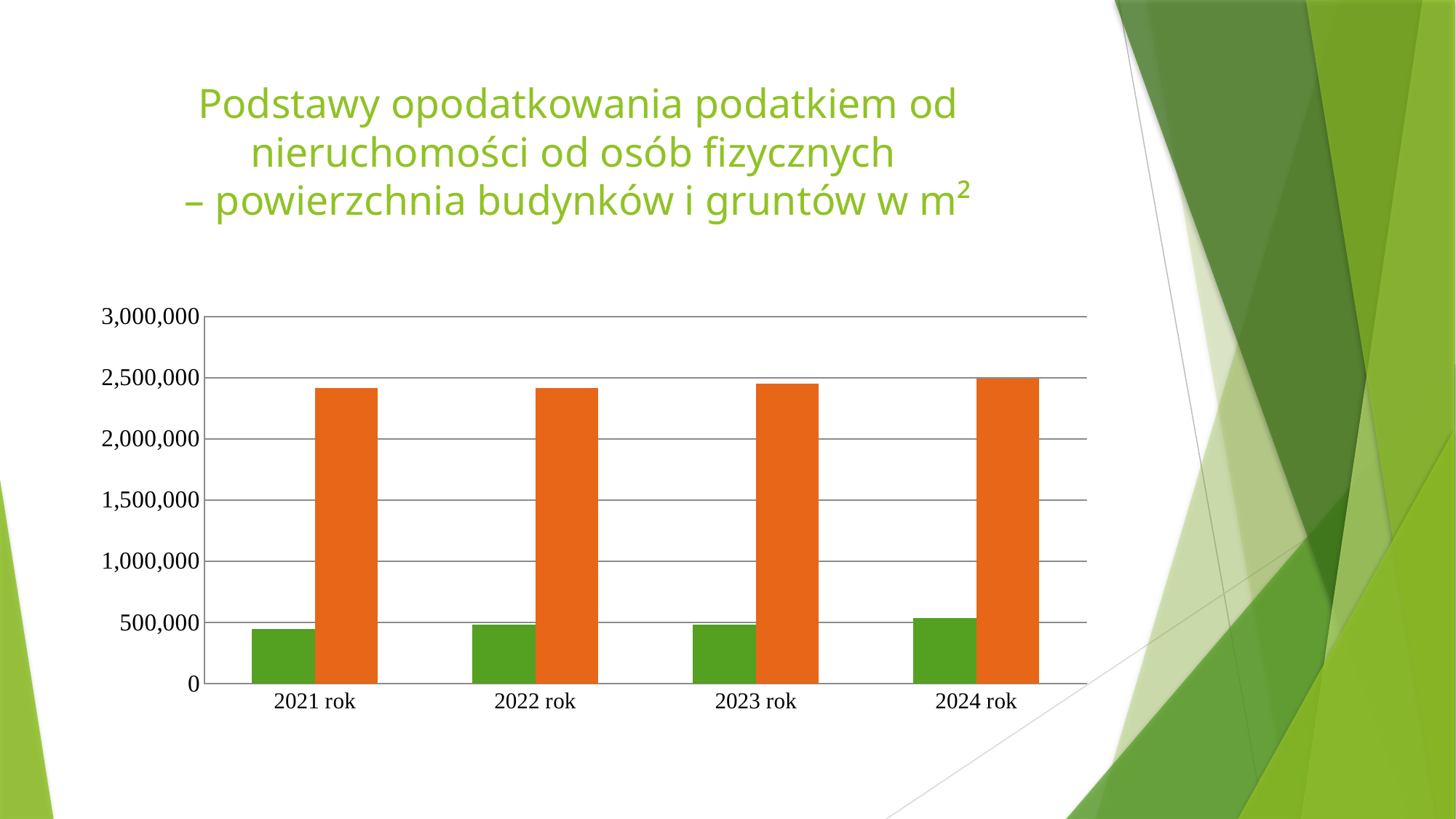
For 2021 rok, which bar is larger, the green one or the orange one? the orange one Is the value of the green bar for 2024 rok greater or less than 500,000? greater Is the value of the orange bar for 2021 rok greater or less than 2,000,000? greater What is the highest value shown on the vertical axis of the chart? 3,000,000 How many bars are shown for each year in the chart? 2 What kind of chart is shown on the slide? bar chart Do the green bars rise or fall from 2021 rok to 2024 rok? rise Is the value of the green bar for 2021 rok greater or less than 500,000? less How many year categories are shown on the x axis of the chart? 4 In which year is the orange bar the highest? 2024 rok In which year is the green bar the highest? 2024 rok